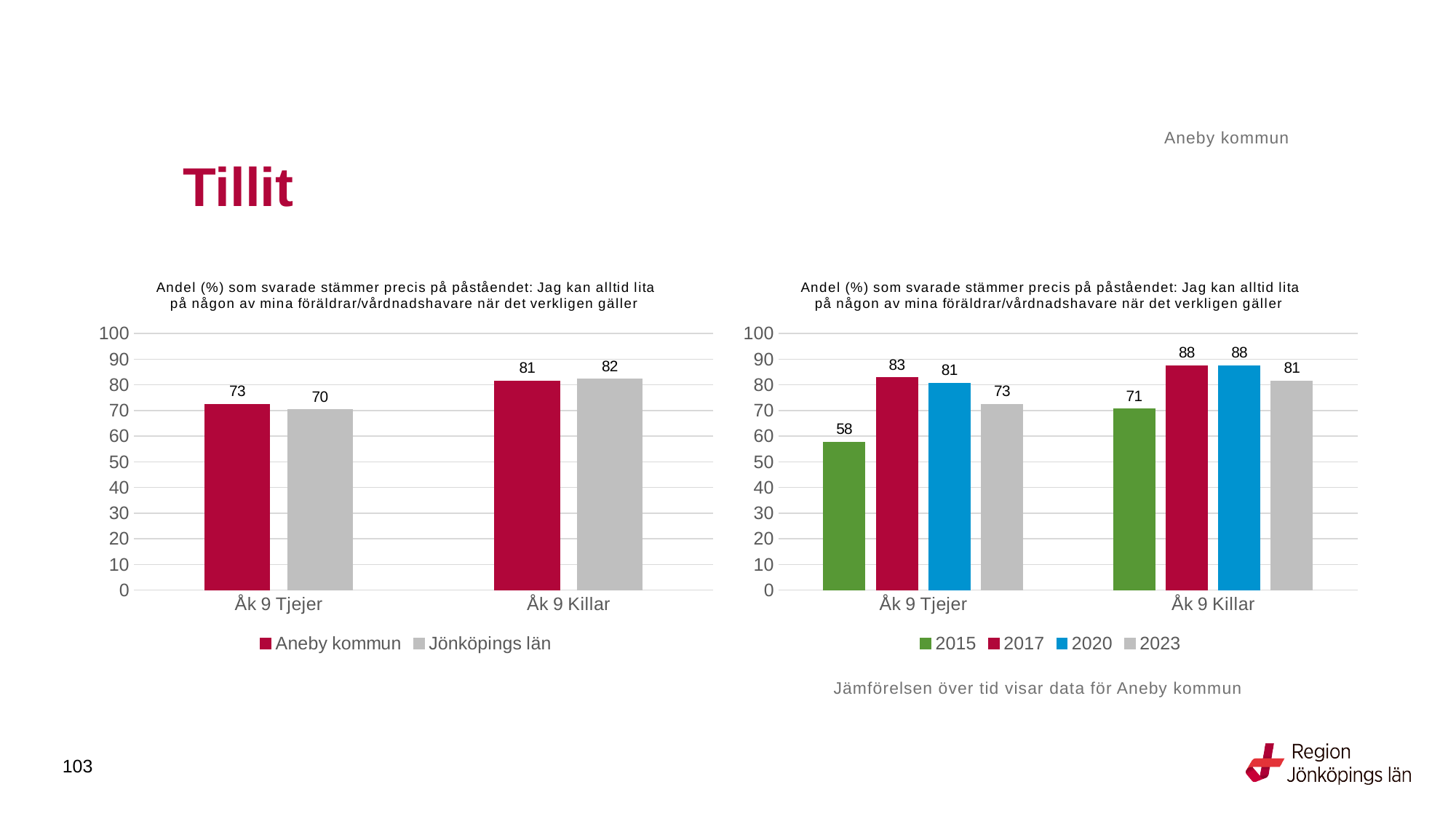
In the right chart, how many series does the legend list? 4 In the left chart, what is the difference between Aneby kommun and Jönköpings län for Åk 9 Tjejer? 3 In the left chart, what is the value for Aneby kommun for Åk 9 Tjejer? 73 In the left chart, what is the value for Jönköpings län for Åk 9 Killar? 82 In the right chart, what is the value for 2015 for Åk 9 Tjejer? 58 In the right chart, which year has the lowest value for Åk 9 Killar? 2015 In the left chart, which is larger for Åk 9 Killar: Aneby kommun or Jönköpings län? Jönköpings län In the right chart, what is the value for 2023 for Åk 9 Killar? 81 In the right chart, what is the difference between the 2017 and 2015 values for Åk 9 Tjejer? 25 What kind of chart is the right chart? Bar chart In the right chart, how many categories are shown on the x axis? 2 In the left chart, how many series does the legend list? 2